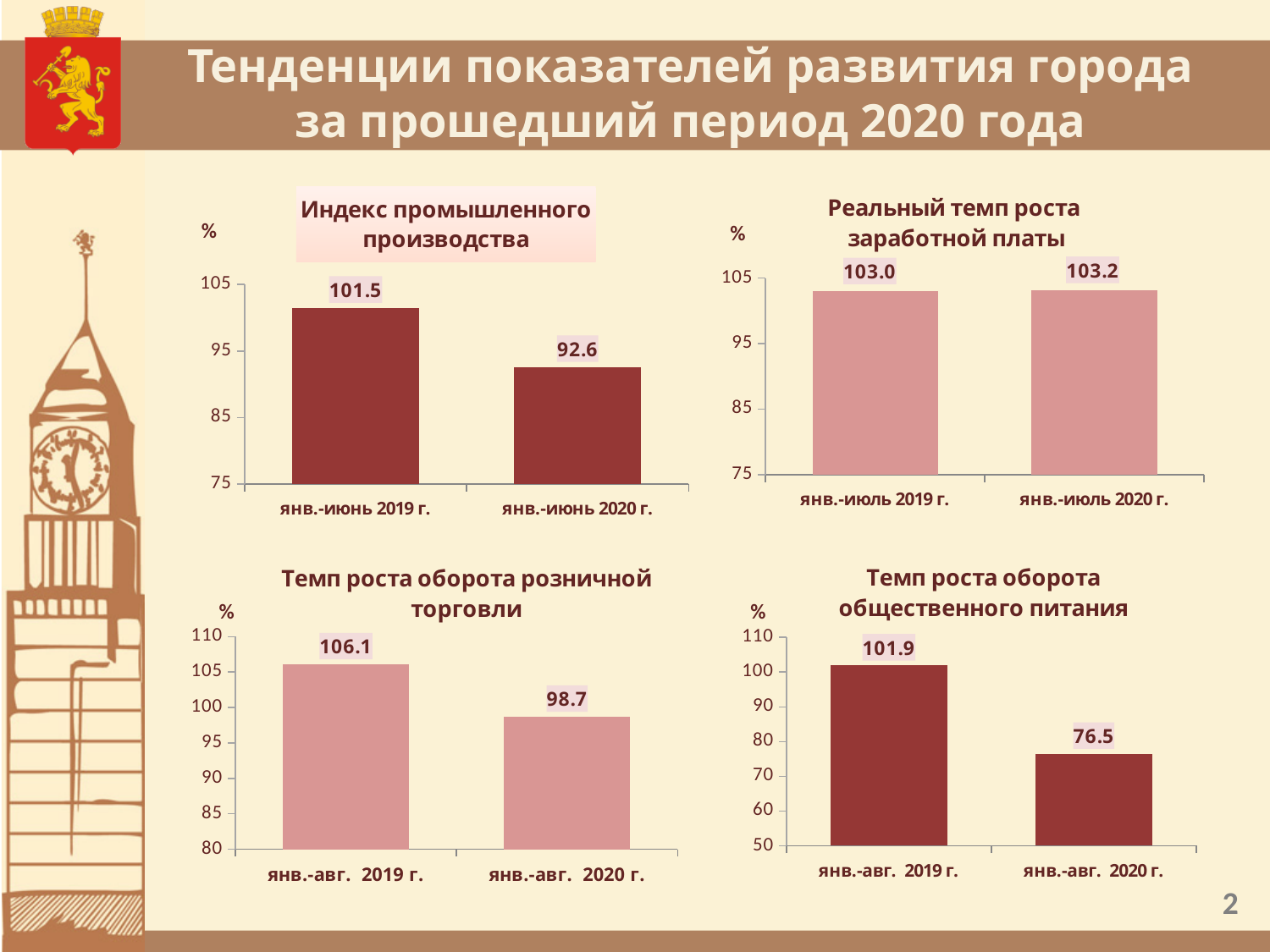
In the chart titled "Индекс промышленного производства", what is the value for янв.-июнь 2020 г.? 92.6 In the chart titled "Реальный темп роста заработной платы", what is the value for янв.-июль 2019 г.? 103.0 What kind of chart is the chart titled "Темп роста оборота розничной торговли"? bar chart In the chart titled "Индекс промышленного производства", do the values rise or fall from 2019 to 2020? fall In the chart titled "Реальный темп роста заработной платы", what is the value for янв.-июль 2020 г.? 103.2 In the chart titled "Темп роста оборота розничной торговли", which period has the highest value? янв.-авг. 2019 г. In the chart titled "Индекс промышленного производства", what is the difference between the values for янв.-июнь 2019 г. and янв.-июнь 2020 г.? 8.9 In the chart titled "Темп роста оборота общественного питания", what is the value for янв.-авг. 2020 г.? 76.5 How many bars are in the chart titled "Реальный темп роста заработной платы"? 2 In the chart titled "Темп роста оборота общественного питания", what is the difference between the values for янв.-авг. 2019 г. and янв.-авг. 2020 г.? 25.4 In the chart titled "Темп роста оборота общественного питания", is the value for янв.-авг. 2020 г. greater or less than 80? less In the chart titled "Темп роста оборота розничной торговли", what is the value for янв.-авг. 2020 г.? 98.7